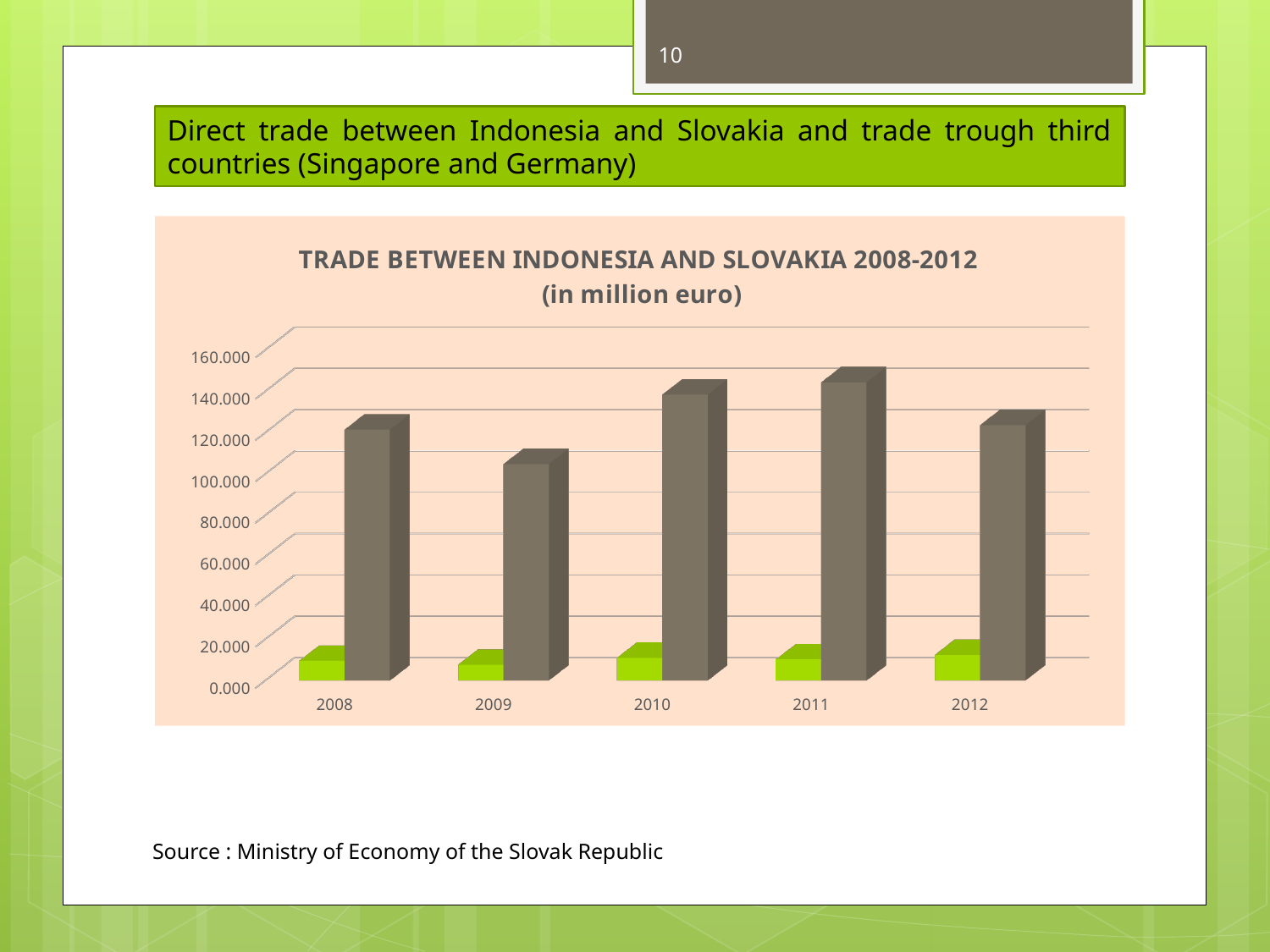
Is the value of the brown bar for 2010 greater or less than 120.000? greater In 2008, which bar is larger, the green bar or the brown bar? the brown bar Is the value of the brown bar for 2008 greater or less than 140.000? less How many years are shown on the x axis of the chart? 5 What is the title of the chart? TRADE BETWEEN INDONESIA AND SLOVAKIA 2008-2012 (in million euro) In what unit are the values in the chart expressed? million euro In which year is the brown bar the shortest? 2009 In which year is the brown bar the tallest? 2011 Is the value of the green bar for 2012 greater or less than 20.000? less Which year has the larger brown bar, 2009 or 2010? 2010 What kind of chart is shown on the slide? bar chart